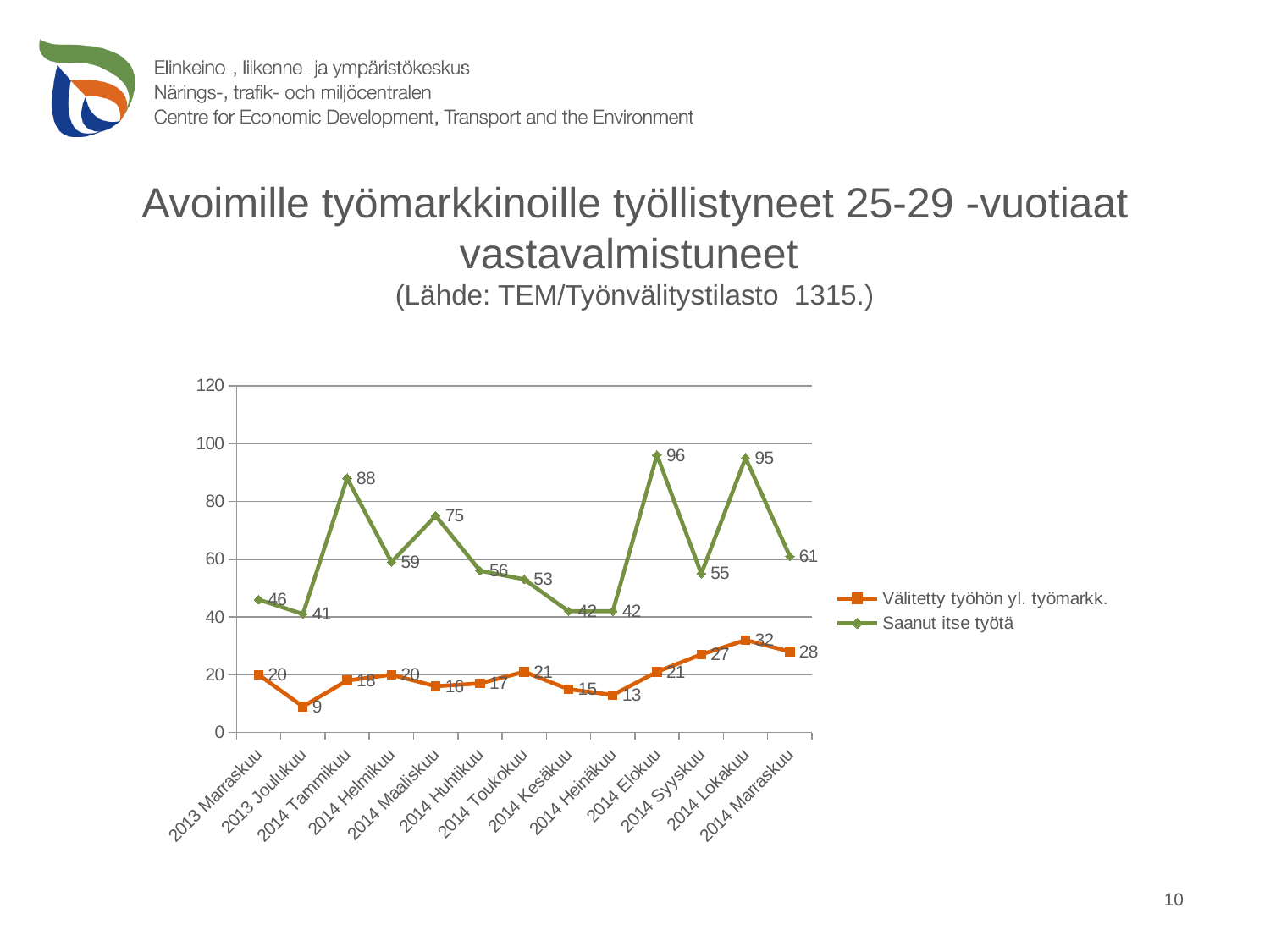
Does 'Välitetty työhön yl. työmarkk.' rise or fall from 2014 Heinäkuu to 2014 Lokakuu? Rise What is the value of 'Välitetty työhön yl. työmarkk.' for 2014 Lokakuu? 32 What is the difference between 'Saanut itse työtä' and 'Välitetty työhön yl. työmarkk.' in 2014 Elokuu? 75 How many series does the legend list? 2 In which month does 'Saanut itse työtä' reach its highest value? 2014 Elokuu What is the value of 'Saanut itse työtä' for 2014 Tammikuu? 88 What kind of chart is shown on the slide? Line chart How many months (categories) are plotted along the x axis? 13 What is the source given in the chart title? TEM/Työnvälitystilasto 1315. Is the value of 'Saanut itse työtä' for 2014 Lokakuu greater or less than 80? greater In which month is 'Välitetty työhön yl. työmarkk.' at its lowest? 2013 Joulukuu Which is larger in 2014 Marraskuu: 'Saanut itse työtä' or 'Välitetty työhön yl. työmarkk.'? Saanut itse työtä